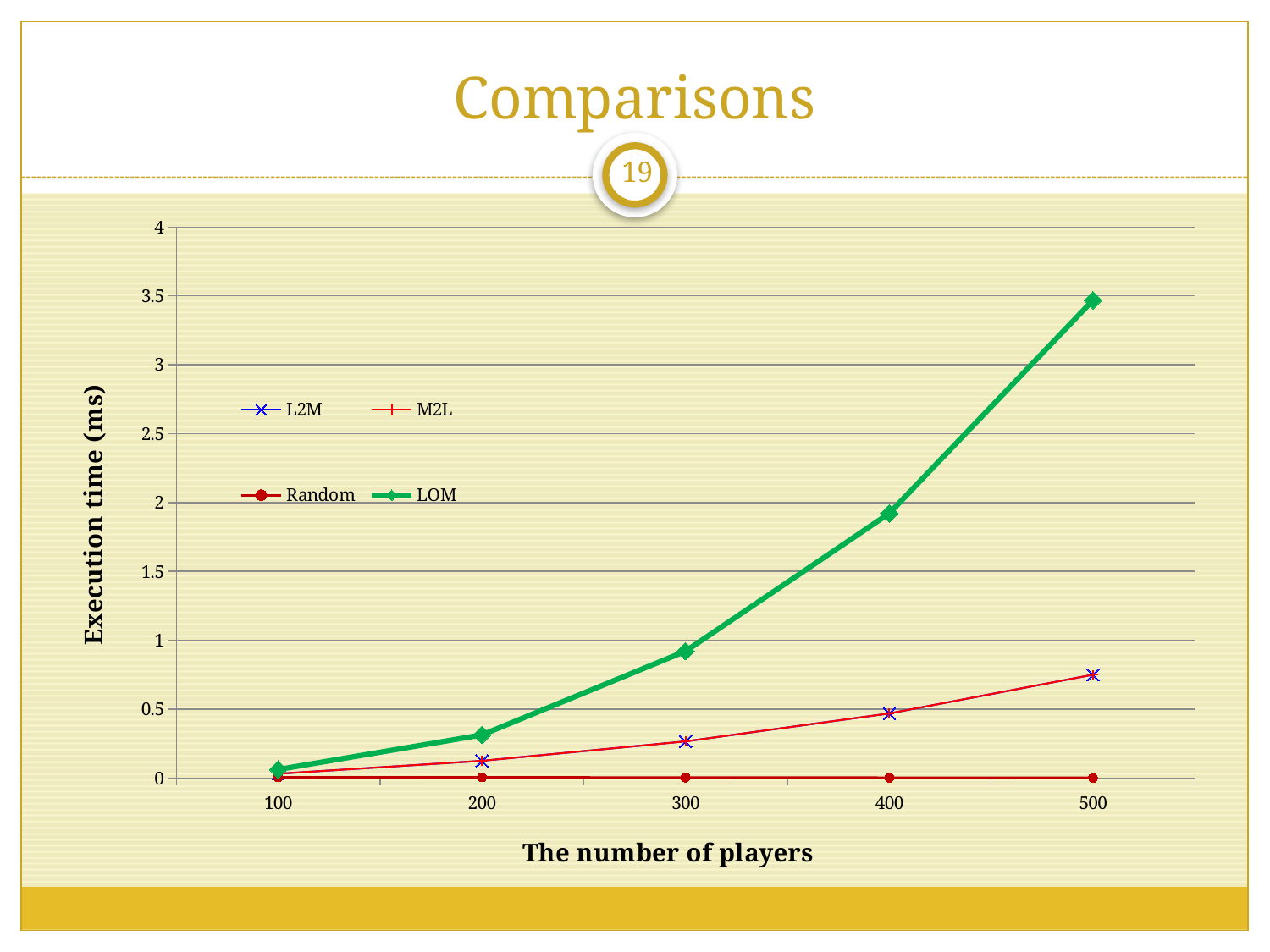
Does the execution time for LOM rise or fall as the number of players increases? rises How many series does the legend list? 4 Which series has the lowest execution time at 500 players? Random Is the execution time for LOM at 400 players greater or less than 1.5? greater How many values of the number of players are plotted along the x axis? 5 Which is larger at 400 players, the execution time for LOM or for L2M? LOM Is the execution time for LOM at 300 players greater or less than 1? less Is the execution time for L2M at 500 players greater or less than 0.5? greater What kind of chart is shown on the slide? line chart Which series has the highest execution time at 500 players? LOM What is the label of the y axis? Execution time (ms)